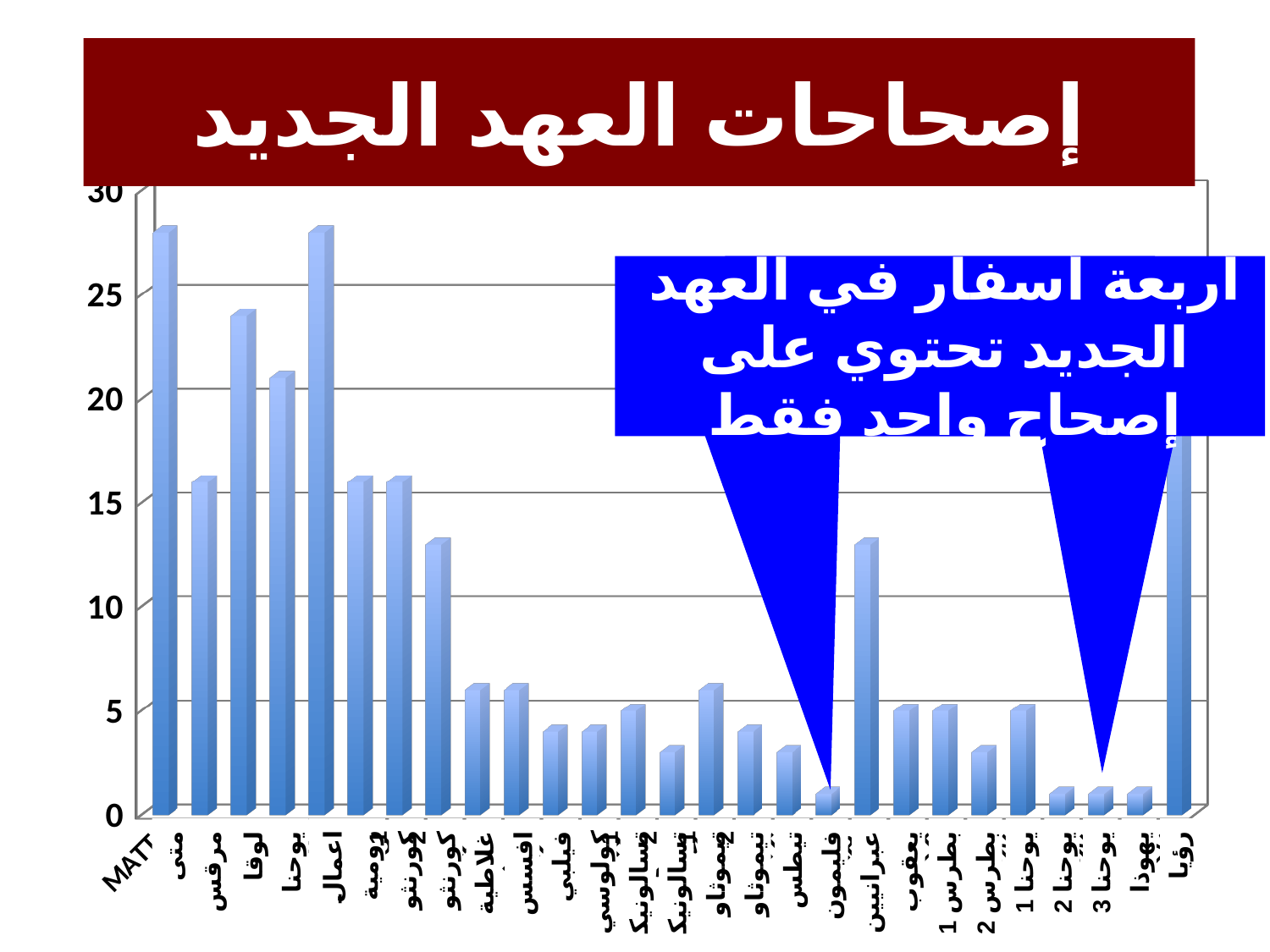
Is the value for 2تسالونيك greater or less than 5? less Is the value for فليمون greater or less than 5? less Which has the larger value, لوقا or مرقس? لوقا Which has the larger value, رؤيا or عبرانيين? رؤيا Which has the larger value, عبرانيين or يعقوب? عبرانيين What is the highest value shown on the vertical axis of the chart? 30 Is the value for لوقا greater or less than 20? greater What is the title of the chart on the slide? إصحاحات العهد الجديد What kind of chart is shown on the slide? bar chart